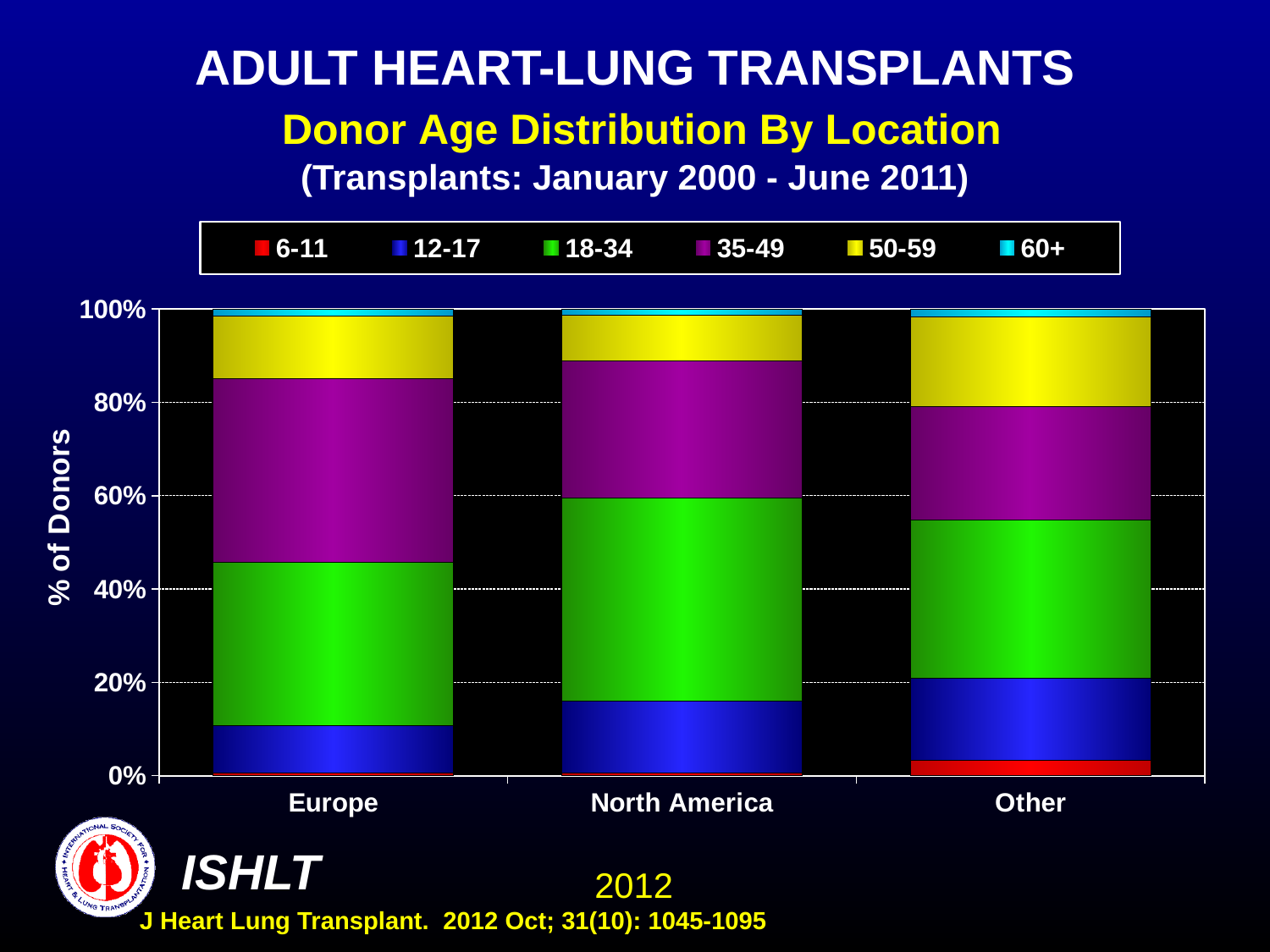
How many locations are shown on the x axis of the chart? 3 What is the subtitle of the chart shown in yellow? Donor Age Distribution By Location Is the share of donors aged 50-59 for North America greater or less than 20%? less Which location has the largest share of donors aged 18-34? North America Is the share of donors aged 35-49 for North America greater or less than 20%? greater Which location has the largest share of donors aged 35-49? Europe How many donor age groups does the legend list? 6 What kind of chart is shown on the slide? Stacked bar chart Which location has the larger share of donors aged 12-17, Europe or Other? Other Is the share of donors aged 18-34 for North America greater or less than 40%? greater What is the label on the y axis of the chart? % of Donors